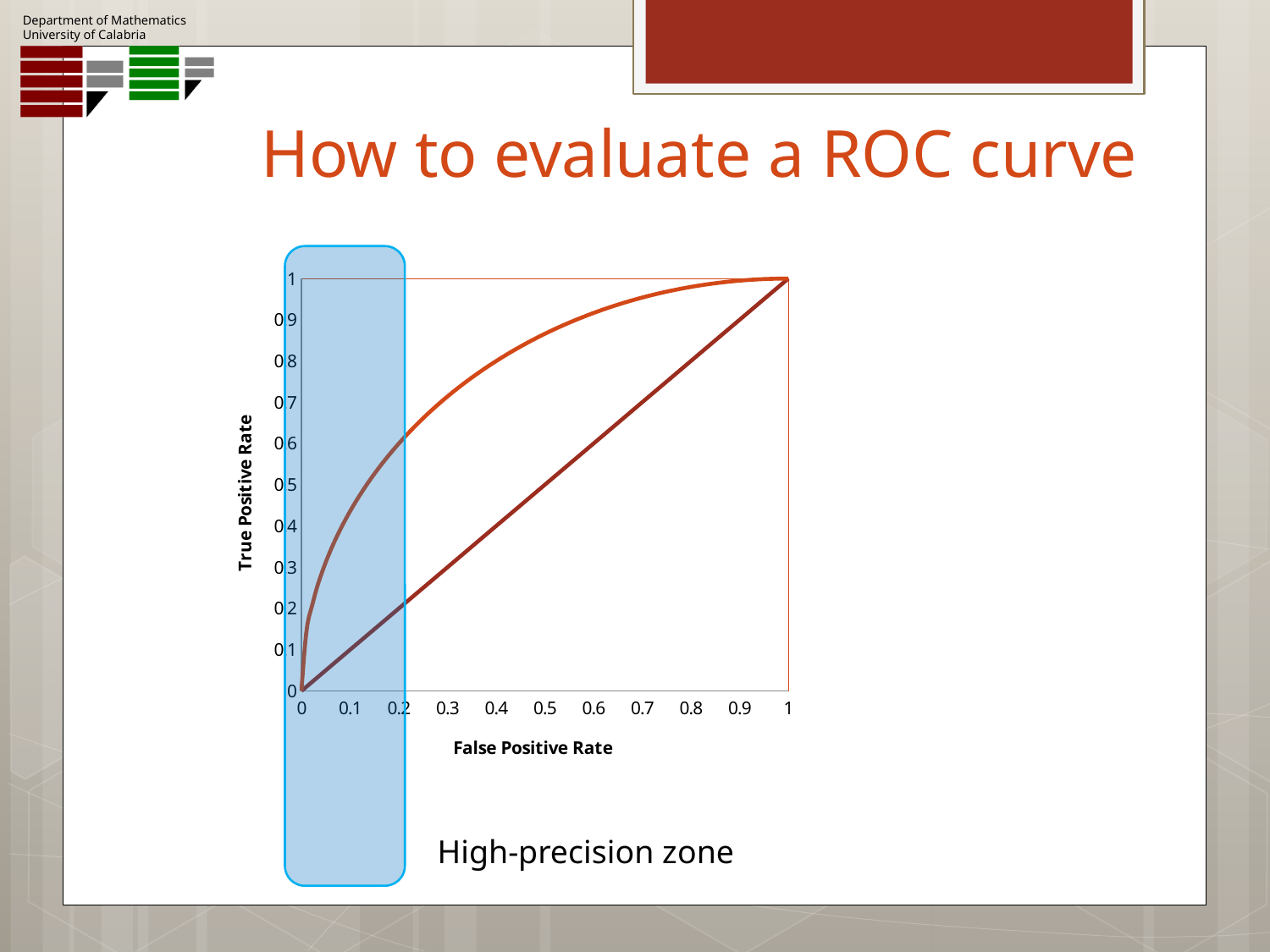
What kind of chart is shown on the slide? Line chart What is the title of the y axis of the chart? True Positive Rate Is the True Positive Rate of the straight diagonal line at a False Positive Rate of 0.2 greater or less than 0.5? less How many lines are plotted on the chart? 2 What is the True Positive Rate of the straight diagonal line when the False Positive Rate is 0? 0 Is the True Positive Rate of the curved line at a False Positive Rate of 0.6 greater or less than 0.8? greater What is the highest value shown on the y axis of the chart? 1 Do the values of the curved line rise or fall as the False Positive Rate increases? Rise What is the True Positive Rate of the curved line when the False Positive Rate is 1? 1 Is the True Positive Rate of the curved line at a False Positive Rate of 0.2 greater or less than 0.5? greater What is the title of the x axis of the chart? False Positive Rate At a False Positive Rate of 0.5, which line has the higher True Positive Rate, the curved line or the straight diagonal line? The curved line